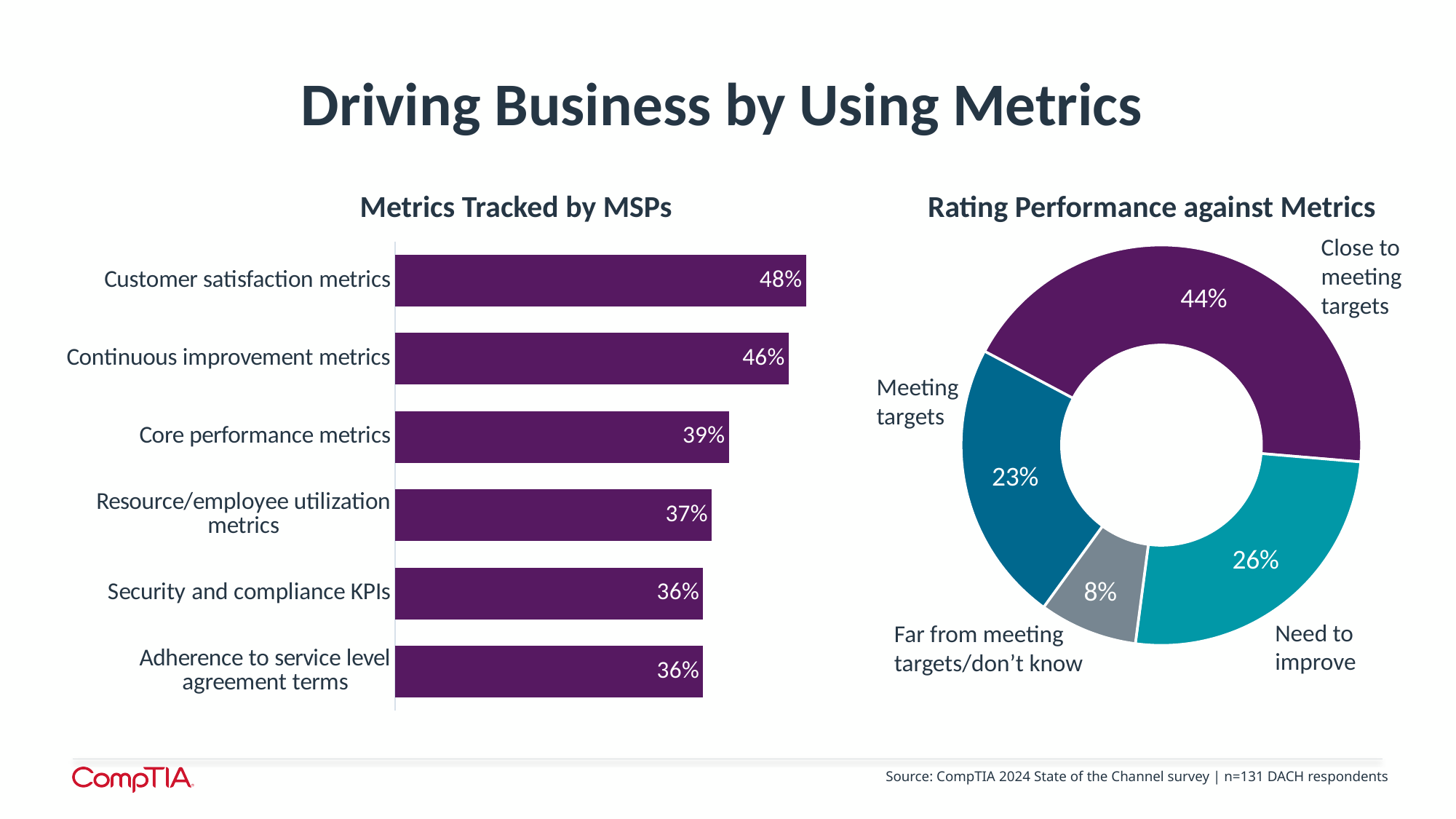
How many categories are shown in the 'Metrics Tracked by MSPs' chart? 6 What kind of chart is 'Rating Performance against Metrics'? Doughnut chart In the 'Metrics Tracked by MSPs' chart, which is larger: Continuous improvement metrics or Resource/employee utilization metrics? Continuous improvement metrics In the 'Rating Performance against Metrics' chart, which segment is the smallest? Far from meeting targets/don't know In the 'Rating Performance against Metrics' chart, what share is 'Need to improve'? 26% In the 'Metrics Tracked by MSPs' chart, what is the value for Core performance metrics? 39% In the 'Metrics Tracked by MSPs' chart, what is the value for Customer satisfaction metrics? 48% In the 'Rating Performance against Metrics' chart, what is the difference between 'Close to meeting targets' and 'Meeting targets'? 21% In the 'Metrics Tracked by MSPs' chart, which category has the highest value? Customer satisfaction metrics What kind of chart is 'Metrics Tracked by MSPs'? Bar chart How many segments does the 'Rating Performance against Metrics' chart have? 4 In the 'Metrics Tracked by MSPs' chart, what is the difference between Customer satisfaction metrics and Security and compliance KPIs? 12%